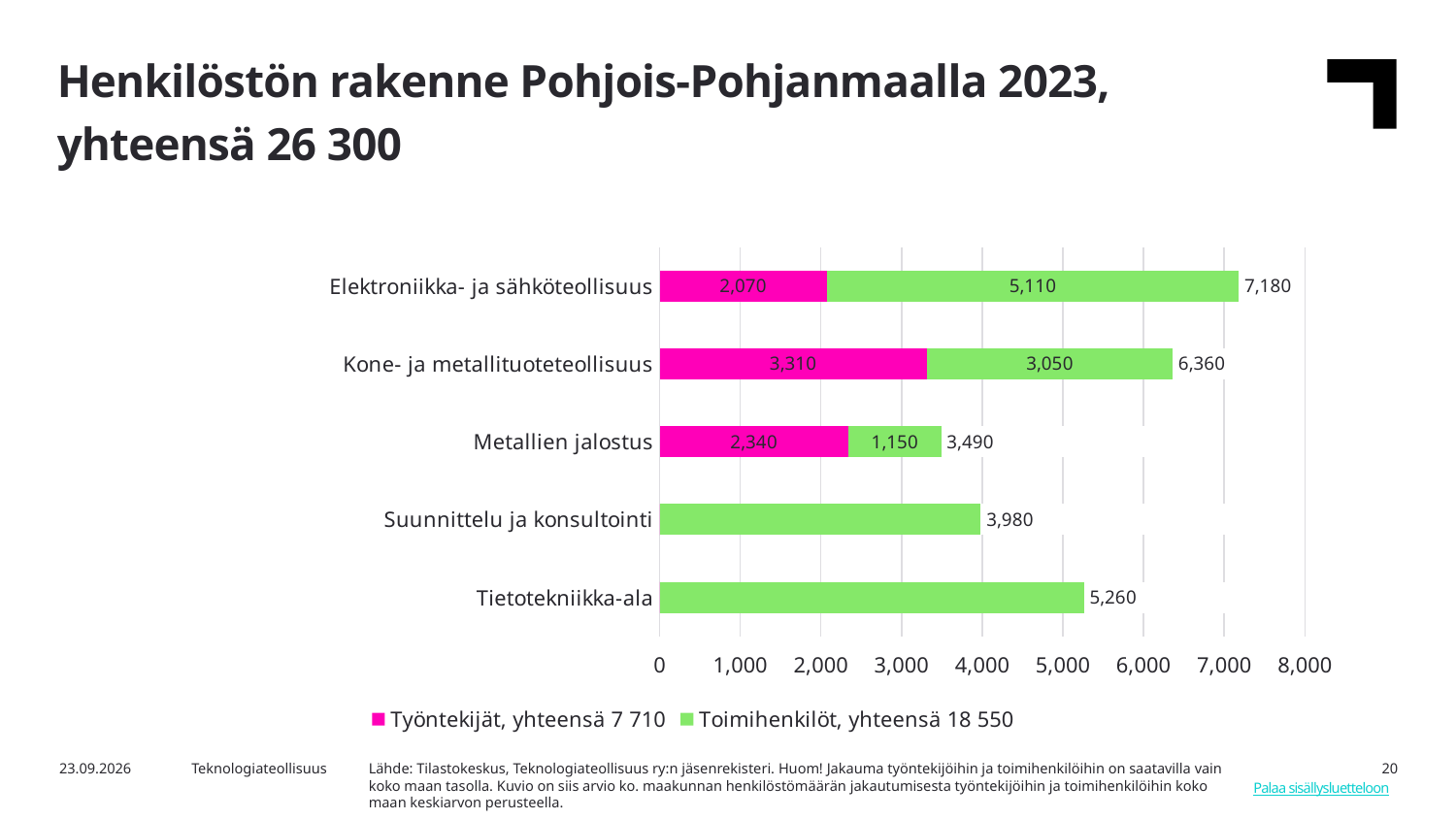
What is the difference between the Työntekijät and Toimihenkilöt values for Metallien jalostus? 1,190 What kind of chart is shown on the slide? Stacked bar chart Which is larger for Kone- ja metallituoteteollisuus: the Työntekijät value or the Toimihenkilöt value? Työntekijät Which category has the lowest total? Metallien jalostus What is the Toimihenkilöt value for Elektroniikka- ja sähköteollisuus? 5,110 Which category has the highest total? Elektroniikka- ja sähköteollisuus What is the total shown for Tietotekniikka-ala? 5,260 Is the total for Suunnittelu ja konsultointi greater or less than 4,000? less How many series does the legend list? 2 What is the Työntekijät value for Kone- ja metallituoteteollisuus? 3,310 How many categories are shown on the chart? 5 What is the total of the stacked bar for Kone- ja metallituoteteollisuus? 6,360